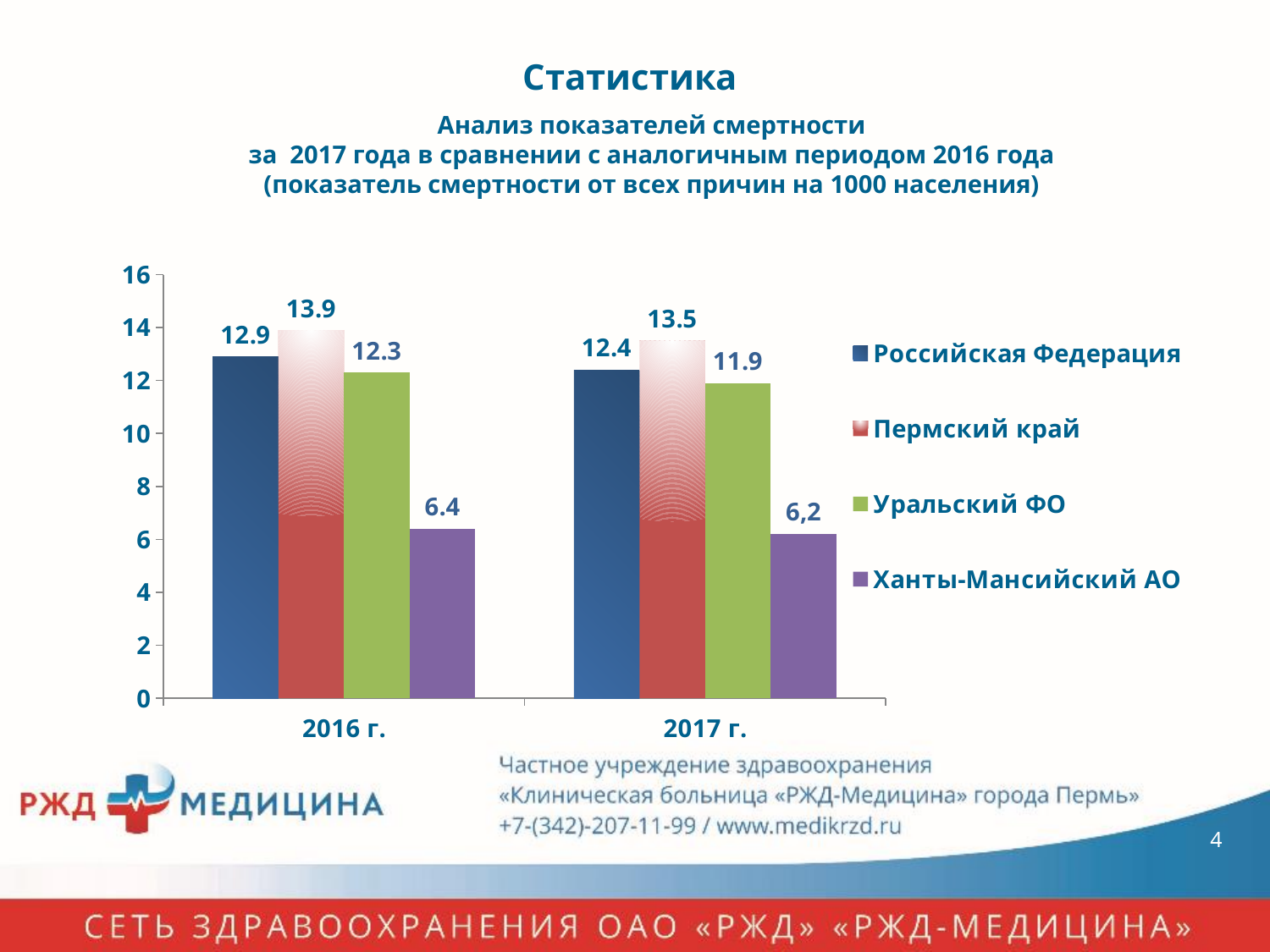
What is the difference between the Российская Федерация values for 2016 г. and 2017 г.? 0.5 Which series has the highest value in 2017 г.? Пермский край What is the value for Российская Федерация in 2017 г.? 12.4 What is the value for Ханты-Мансийский АО in 2017 г.? 6,2 How many year categories are shown on the x axis? 2 Which is larger: the Уральский ФО value in 2016 г. or in 2017 г.? 2016 г. Which series has the lowest value in 2016 г.? Ханты-Мансийский АО How many series does the legend list? 4 Does the value for Пермский край in 2017 г. rise or fall compared with 2016 г.? fall What kind of chart is shown on the slide? bar chart What is the value for Уральский ФО in 2016 г.? 12.3 What is the value for Пермский край in 2016 г.? 13.9